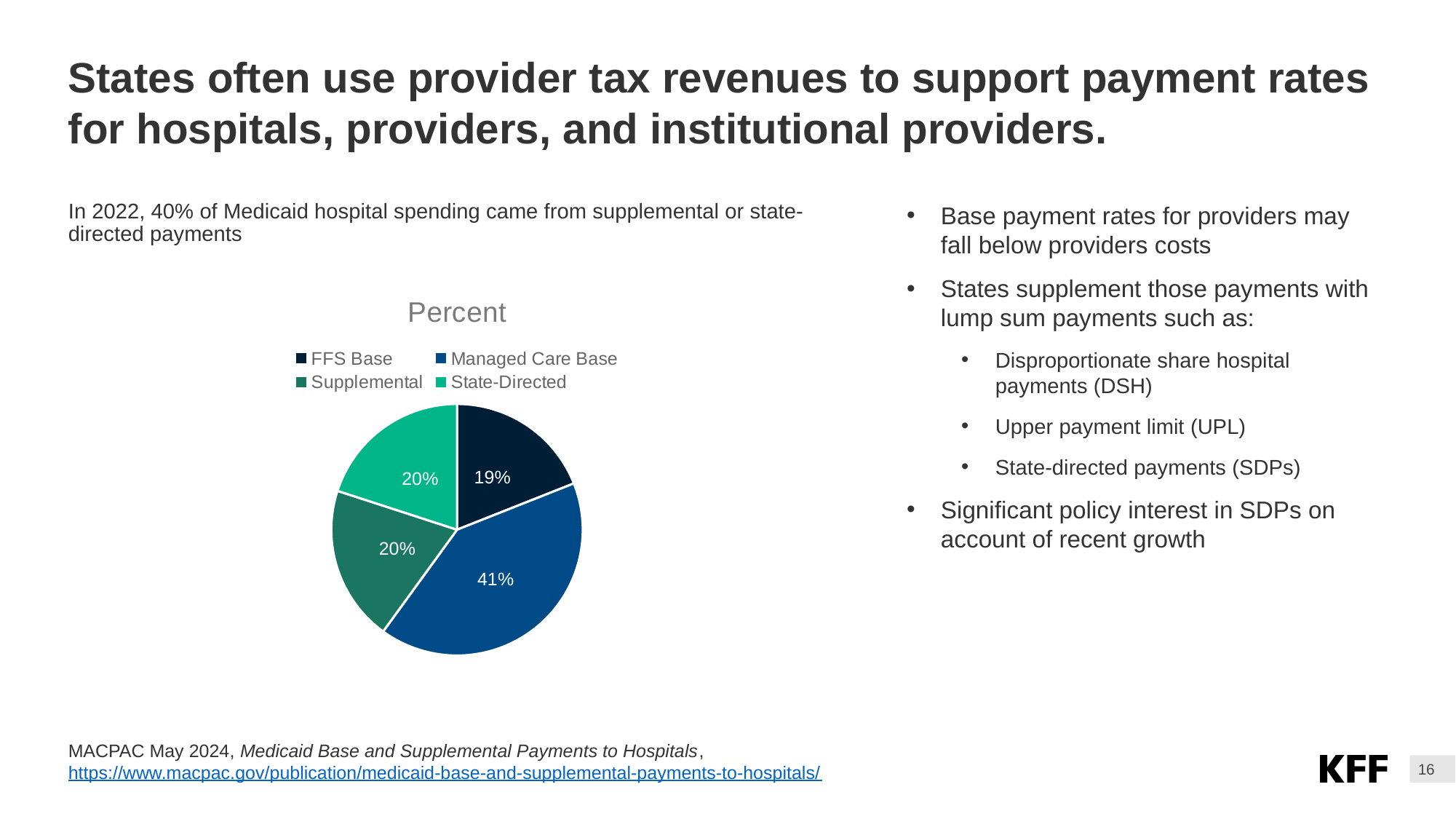
What is the difference between the Managed Care Base share and the FFS Base share? 22 percentage points What is the title of the chart? Percent What percentage of the pie is State-Directed? 20% Which category has the smallest share of the pie? FFS Base Which is larger, the Managed Care Base share or the Supplemental share? Managed Care Base How many categories does the legend list? 4 What is the combined share of Supplemental and State-Directed payments? 40% What percentage of the pie is Supplemental? 20% What percentage of the pie is FFS Base? 19% What percentage of the pie is Managed Care Base? 41% Which category has the largest share of the pie? Managed Care Base What type of chart is shown on the slide? Pie chart